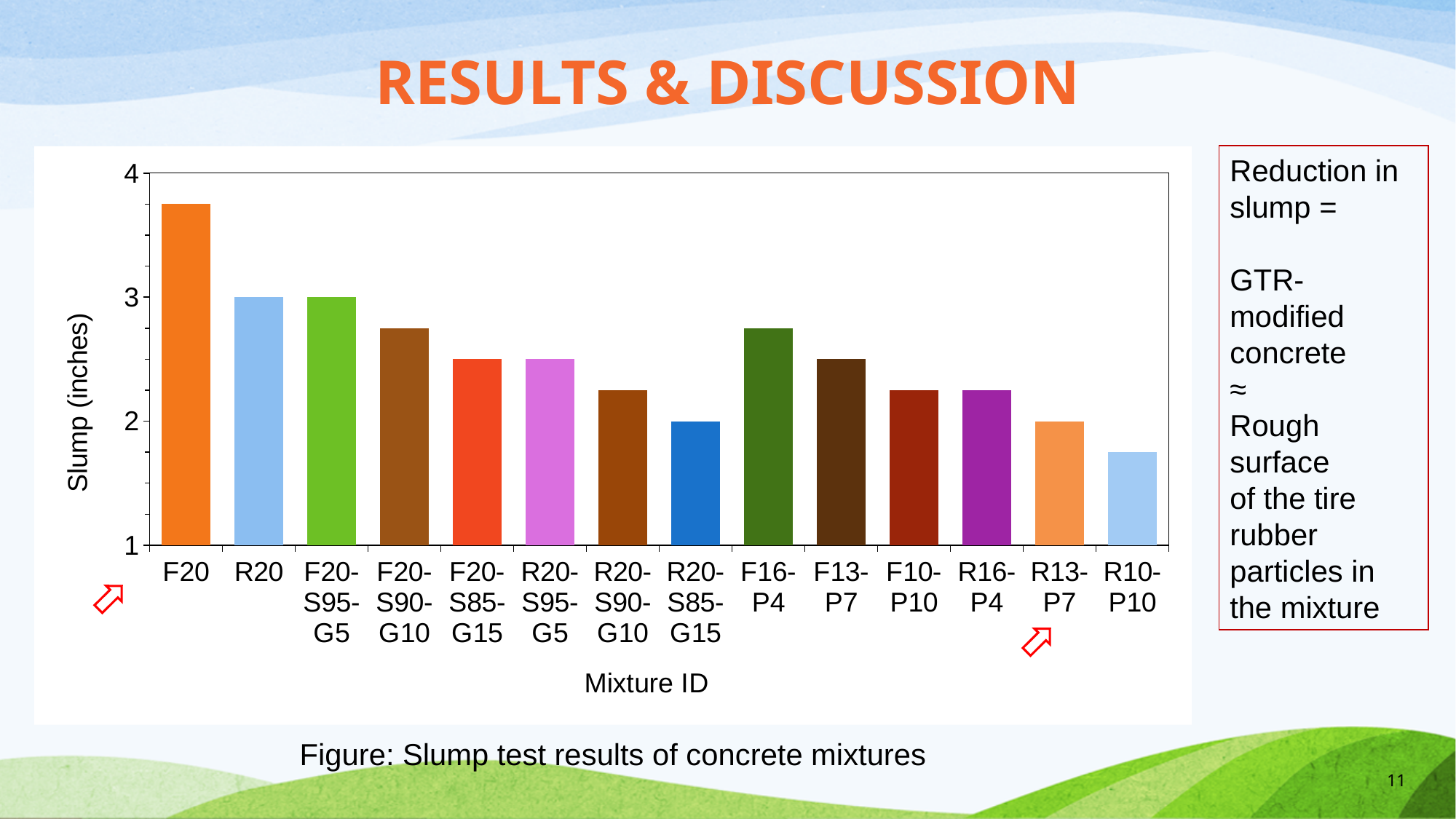
Which mixture has the highest slump? F20 Which has a larger slump, F20 or R20? F20 Is the slump for R10-P10 greater or less than 2? less Which has a larger slump, F16-P4 or R13-P7? F16-P4 Which mixture has the lowest slump? R10-P10 Is the slump for F20 greater or less than 3? greater What is the label of the y axis? Slump (inches) What kind of chart is shown on the slide? bar chart Is the slump for F20-S90-G10 greater or less than 3? less How many mixture IDs are plotted on the x axis? 14 What is the slump value for R20? 3 What is the slump value for R20-S85-G15? 2